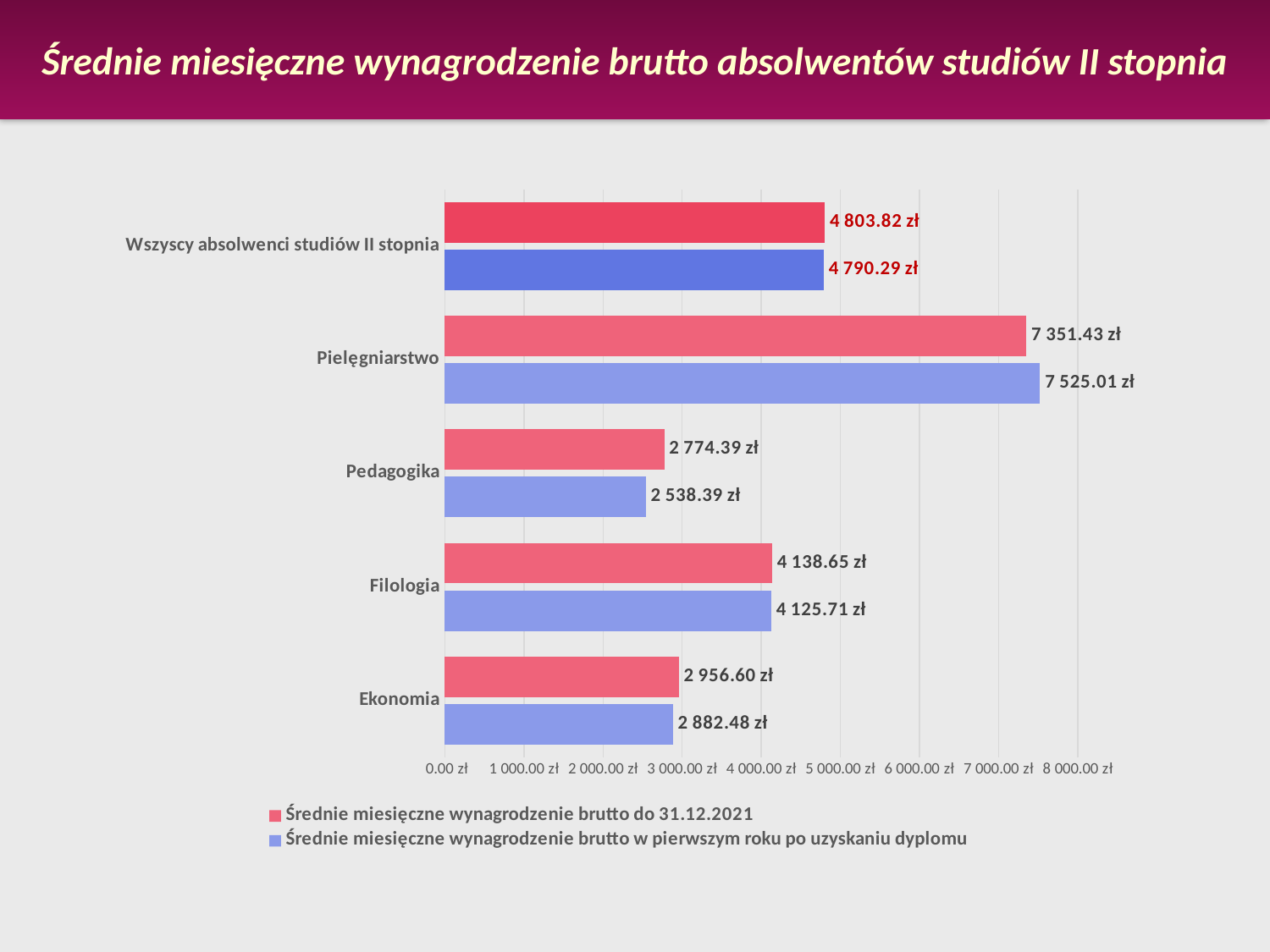
Which category has the highest average monthly gross salary up to 31.12.2021? Pielęgniarstwo What is the average monthly gross salary in the first year after graduation (w pierwszym roku po uzyskaniu dyplomu) for Pedagogika? 2 538.39 zł What is the average monthly gross salary up to 31.12.2021 (Średnie miesięczne wynagrodzenie brutto do 31.12.2021) for Pielęgniarstwo? 7 351.43 zł For Pielęgniarstwo, which is larger: the salary up to 31.12.2021 or the salary in the first year after graduation? The salary in the first year after graduation (7 525.01 zł) What is the difference between the first-year salary and the salary up to 31.12.2021 for Pielęgniarstwo? 173.58 zł What is the value for Ekonomia in the series 'Średnie miesięczne wynagrodzenie brutto do 31.12.2021'? 2 956.60 zł What is the difference between the two series values for Pedagogika? 236.00 zł What is the value for Wszyscy absolwenci studiów II stopnia in the series 'Średnie miesięczne wynagrodzenie brutto w pierwszym roku po uzyskaniu dyplomu'? 4 790.29 zł How many series does the legend list? 2 Which category has the lowest average monthly gross salary in the first year after graduation? Pedagogika How many categories are shown on the chart? 5 What type of chart is shown on the slide? Bar chart